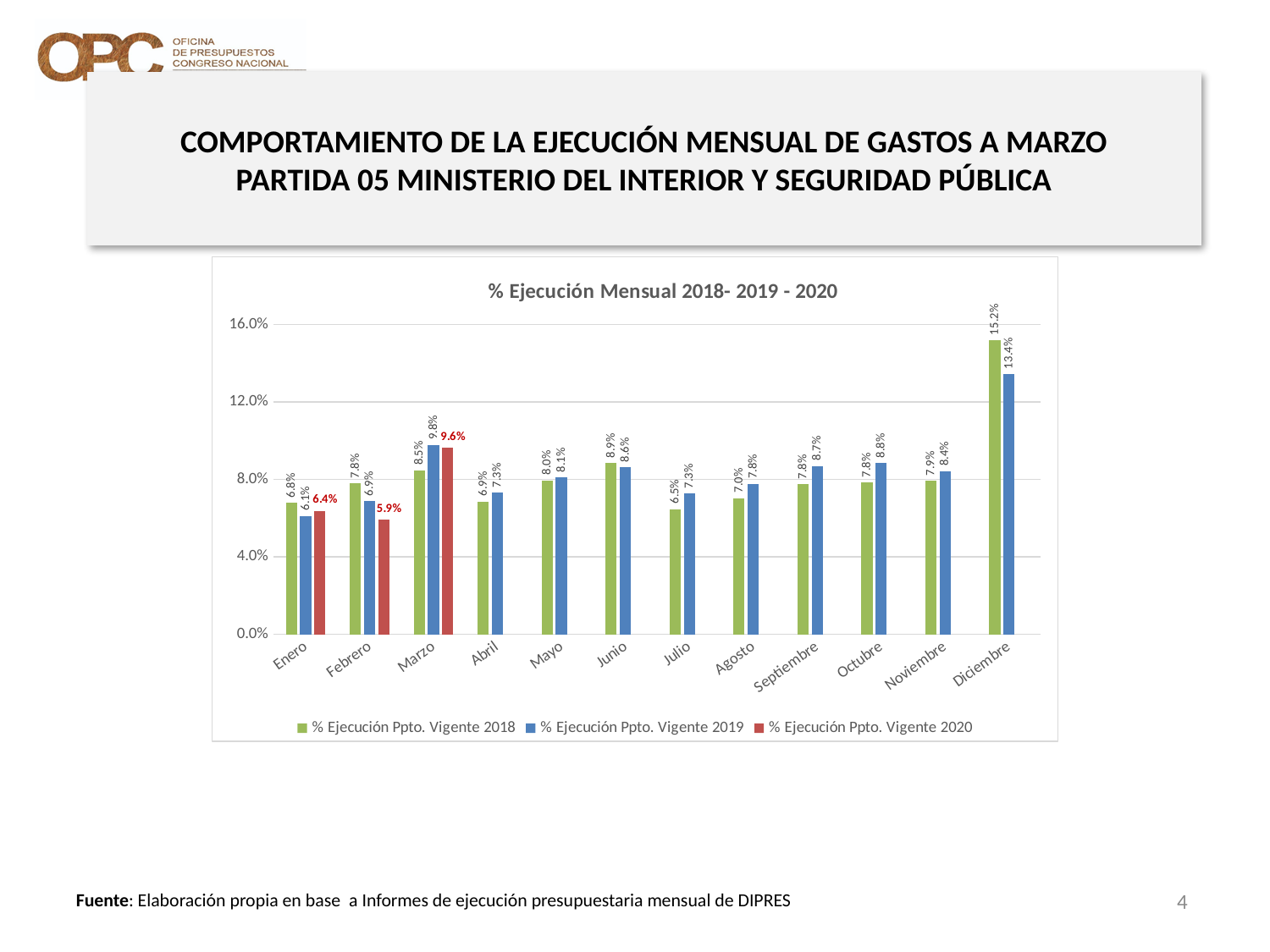
Which month has the highest value for % Ejecución Ppto. Vigente 2019? Diciembre What kind of chart is shown? Bar chart Which month has the lowest value for % Ejecución Ppto. Vigente 2020? Febrero What is the value for % Ejecución Ppto. Vigente 2019 in Febrero? 6.9% What is the difference between the 2018 and 2019 values in Diciembre? 1.8% How many months are shown on the x axis? 12 What is the value for % Ejecución Ppto. Vigente 2020 in Marzo? 9.6% What is the title of the chart? % Ejecución Mensual 2018- 2019 - 2020 What is the value for % Ejecución Ppto. Vigente 2018 in Diciembre? 15.2% How many series does the legend list? 3 Is the value for % Ejecución Ppto. Vigente 2018 in Diciembre greater or less than 12.0%? greater Which is larger in Marzo: the 2019 value or the 2020 value? 2019 (9.8%)